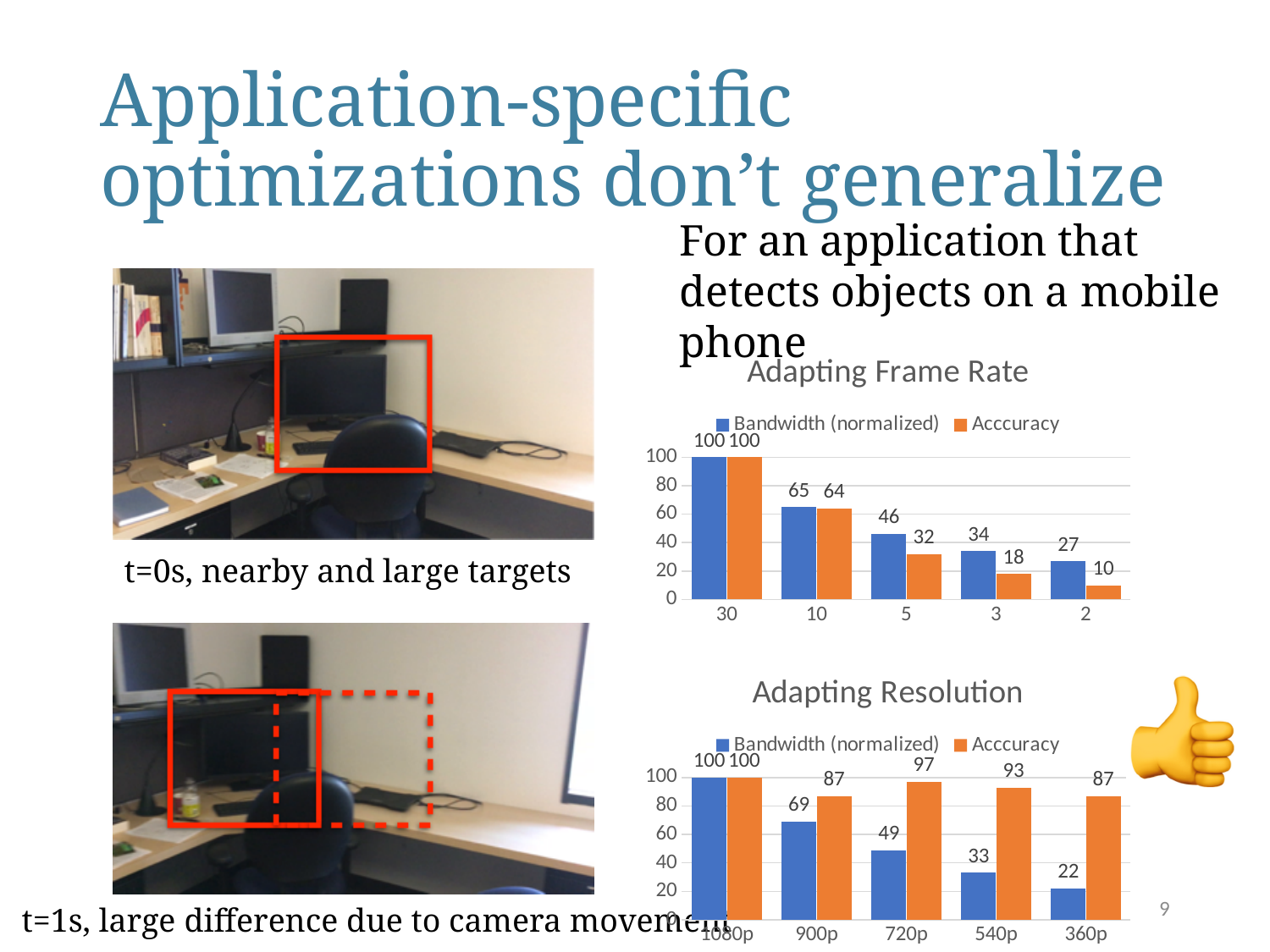
In the Adapting Frame Rate chart, do the Accuracy values rise or fall as the frame rate goes from 30 to 2 along the x axis? fall In the Adapting Resolution chart, which is larger at 540p: Bandwidth (normalized) or Accuracy? Accuracy In the Adapting Frame Rate chart, which frame rate has the lowest Accuracy? 2 How many resolution categories are shown in the Adapting Resolution chart? 5 In the Adapting Resolution chart, what is the Accuracy value at 720p? 97 In the Adapting Frame Rate chart, what is the Accuracy value at frame rate 5? 32 How many series does the legend of the Adapting Frame Rate chart list? 2 In the Adapting Resolution chart, what is the Bandwidth (normalized) value at 360p? 22 In the Adapting Frame Rate chart, what is the Bandwidth (normalized) value at frame rate 3? 34 In the Adapting Resolution chart, which resolution has the highest Accuracy? 1080p In the Adapting Frame Rate chart, what is the difference between Bandwidth (normalized) and Accuracy at frame rate 2? 17 In the Adapting Resolution chart, what is the difference between Accuracy and Bandwidth (normalized) at 900p? 18